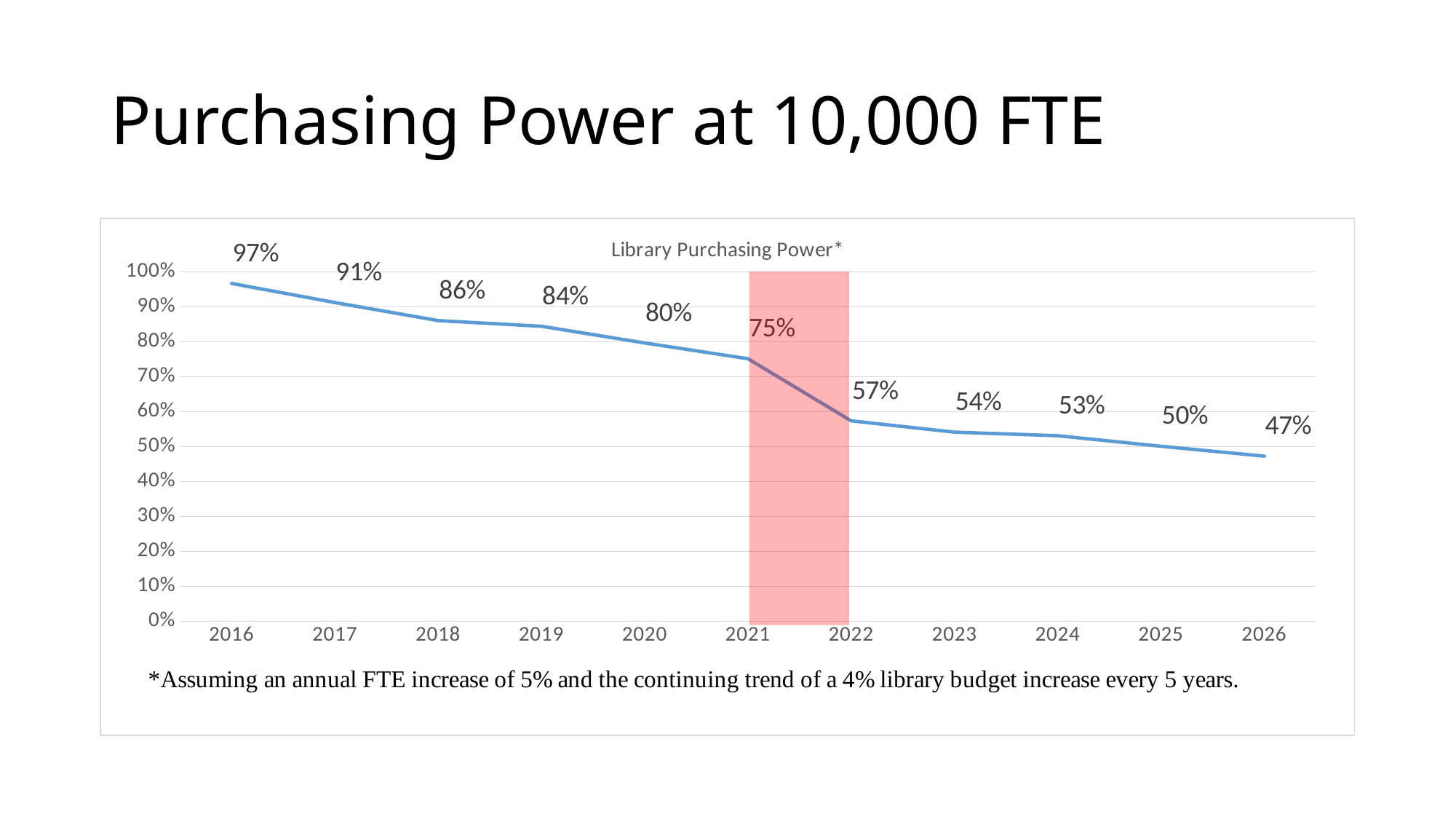
What is the library purchasing power value for 2026? 47% Is the value for 2024 greater or less than 60%? less Do the values rise or fall from 2016 to 2026? fall Which year has a higher purchasing power, 2018 or 2023? 2018 Which year has the highest library purchasing power? 2016 What is the title of the chart? Library Purchasing Power* What is the library purchasing power value for 2016? 97% Which year has the lowest library purchasing power? 2026 What is the difference between the purchasing power in 2021 and in 2022? 18% What is the library purchasing power value for 2021? 75% What kind of chart is shown on the slide? line chart How many years are plotted on the x axis? 11